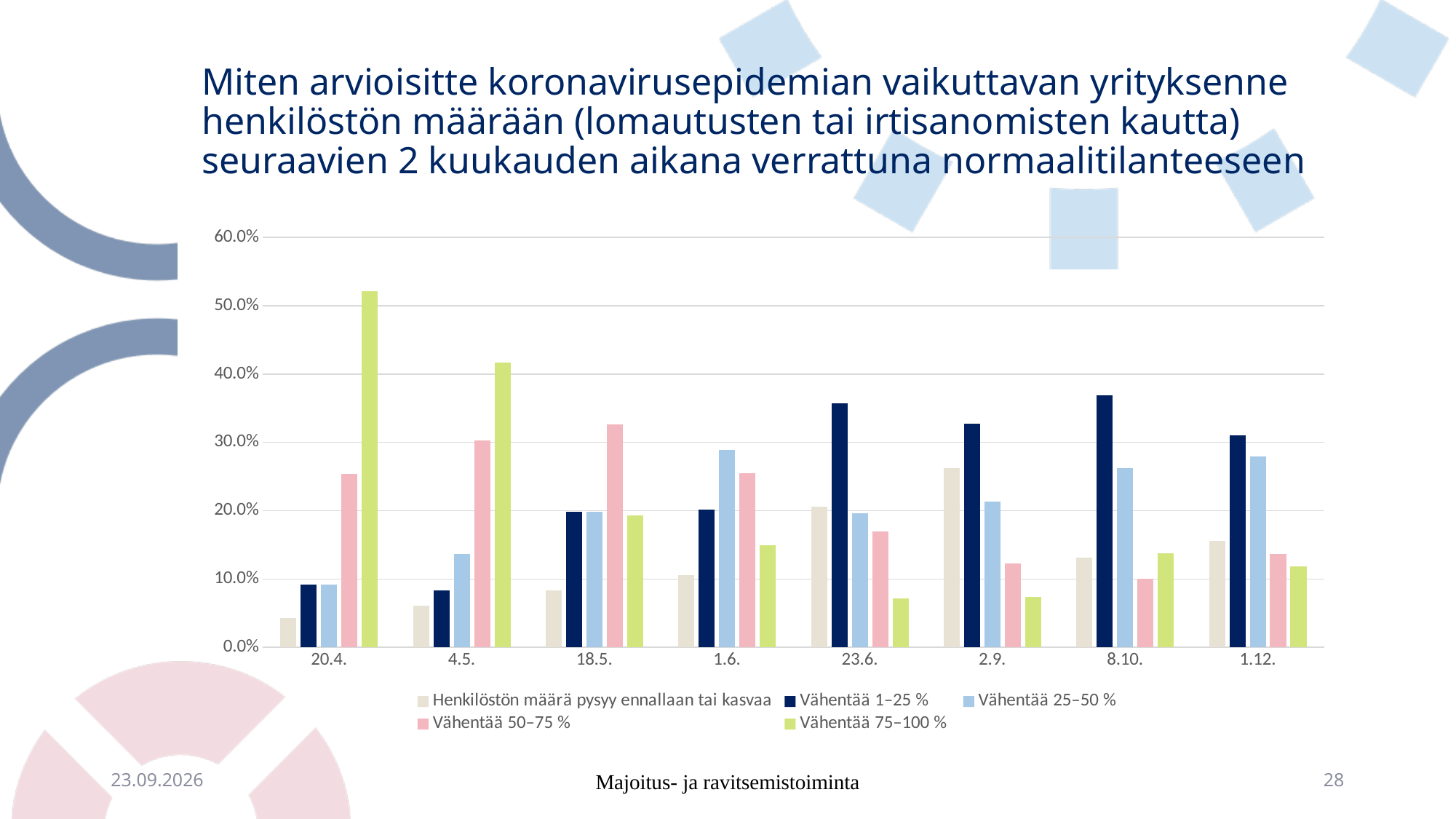
How many survey dates (categories) are shown on the x axis? 8 Is the value for Vähentää 75–100 % at 4.5. greater or less than 40.0%? greater At which date is the value for Henkilöstön määrä pysyy ennallaan tai kasvaa highest? 2.9. Which colour represents Vähentää 75–100 % in the legend? green Is the value for Henkilöstön määrä pysyy ennallaan tai kasvaa at 20.4. greater or less than 10.0%? less How many series does the legend list? 5 Is the value for Vähentää 1–25 % at 8.10. greater or less than 30.0%? greater What kind of chart is shown on the slide? bar chart At 1.6., which is larger: Vähentää 1–25 % or Vähentää 25–50 %? Vähentää 25–50 % At which date is the value for Vähentää 75–100 % highest? 20.4. Does the value for Vähentää 75–100 % rise or fall from 20.4. to 23.6.? fall